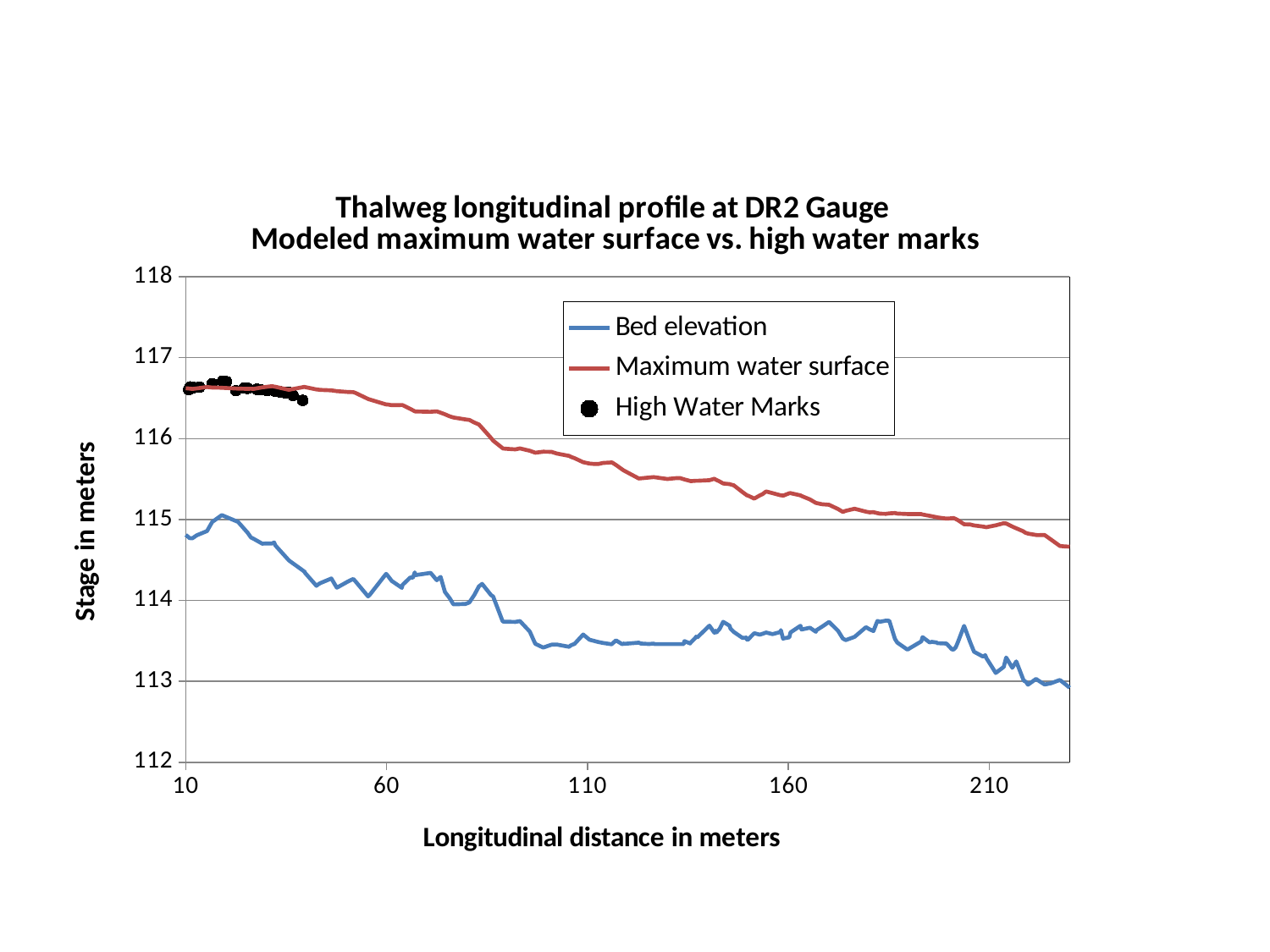
Is the Bed elevation value at 60 m greater or less than 115? less Is the Maximum water surface value at 160 m greater or less than 116? less At a longitudinal distance of 110 m, which is higher: Bed elevation or Maximum water surface? Maximum water surface Does the Maximum water surface line rise or fall as longitudinal distance increases? fall Does the Bed elevation line rise or fall overall from 10 m to 230 m? fall What is the title of the vertical axis? Stage in meters How many series does the legend list? 3 Is the Bed elevation value at 210 m greater or less than 114? less Which series is shown as black dots in the legend? High Water Marks What kind of chart is shown on the slide? line chart